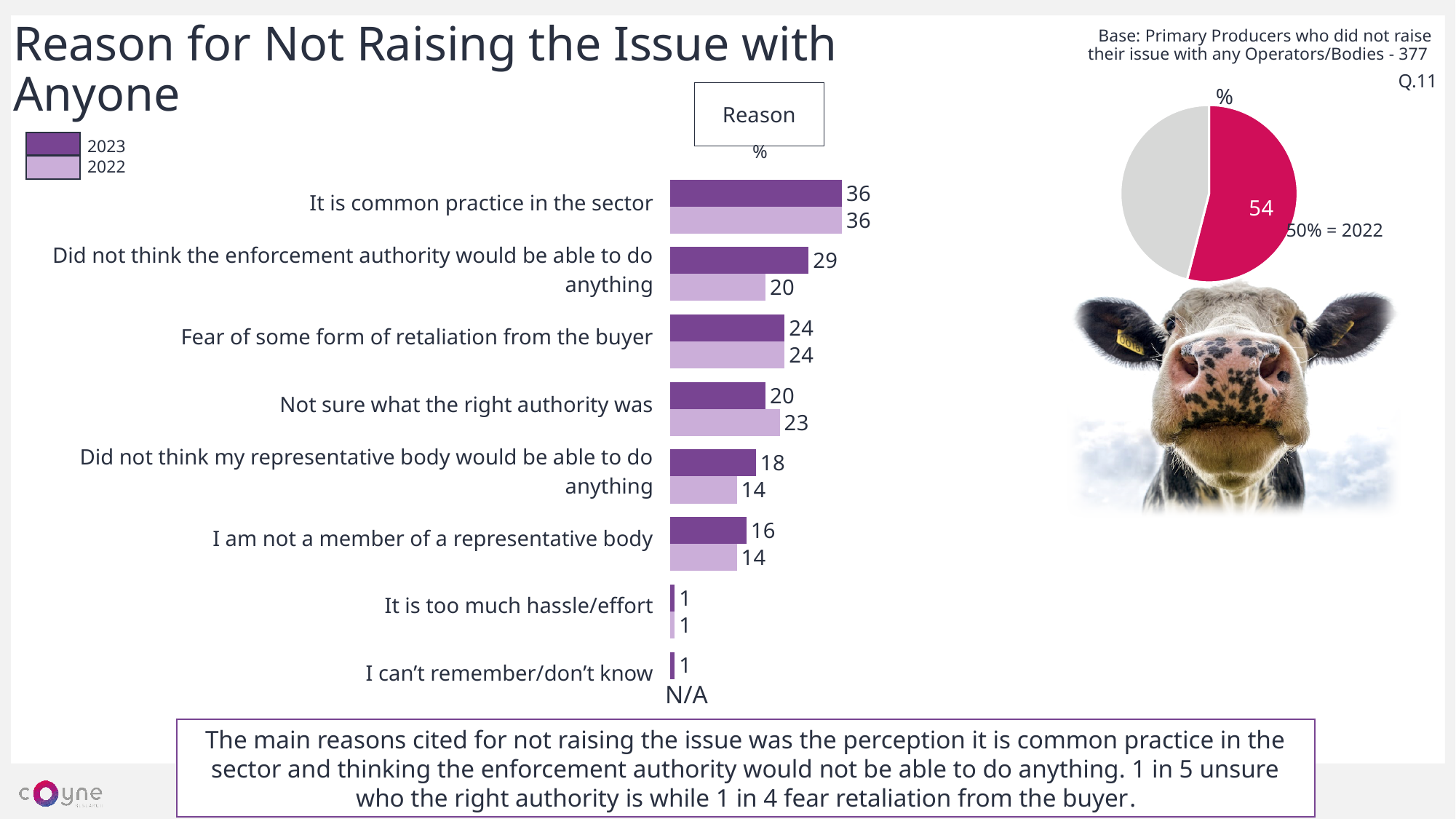
In the Reason bar chart, for "Not sure what the right authority was", which year has the larger value, 2023 or 2022? 2022 How many series does the legend of the Reason bar chart list? 2 In the Reason bar chart, what is the 2023 value for "I am not a member of a representative body"? 16 What kind of chart is the Reason chart on the left of the slide? Bar chart In the Reason bar chart, which reason has the highest 2023 value? It is common practice in the sector In the Reason bar chart, what is shown as the 2022 value for "I can't remember/don't know"? N/A In the pie chart on the right of the slide, what value is printed on the red slice? 54 In the Reason bar chart, what is the 2023 value for "It is common practice in the sector"? 36 What are the two legend entries of the Reason bar chart? 2023 and 2022 How many reasons (categories) are listed in the Reason bar chart? 8 In the Reason bar chart, what is the difference between the 2023 and 2022 values for "Did not think the enforcement authority would be able to do anything"? 9 In the Reason bar chart, what is the 2022 value for "Did not think the enforcement authority would be able to do anything"? 20